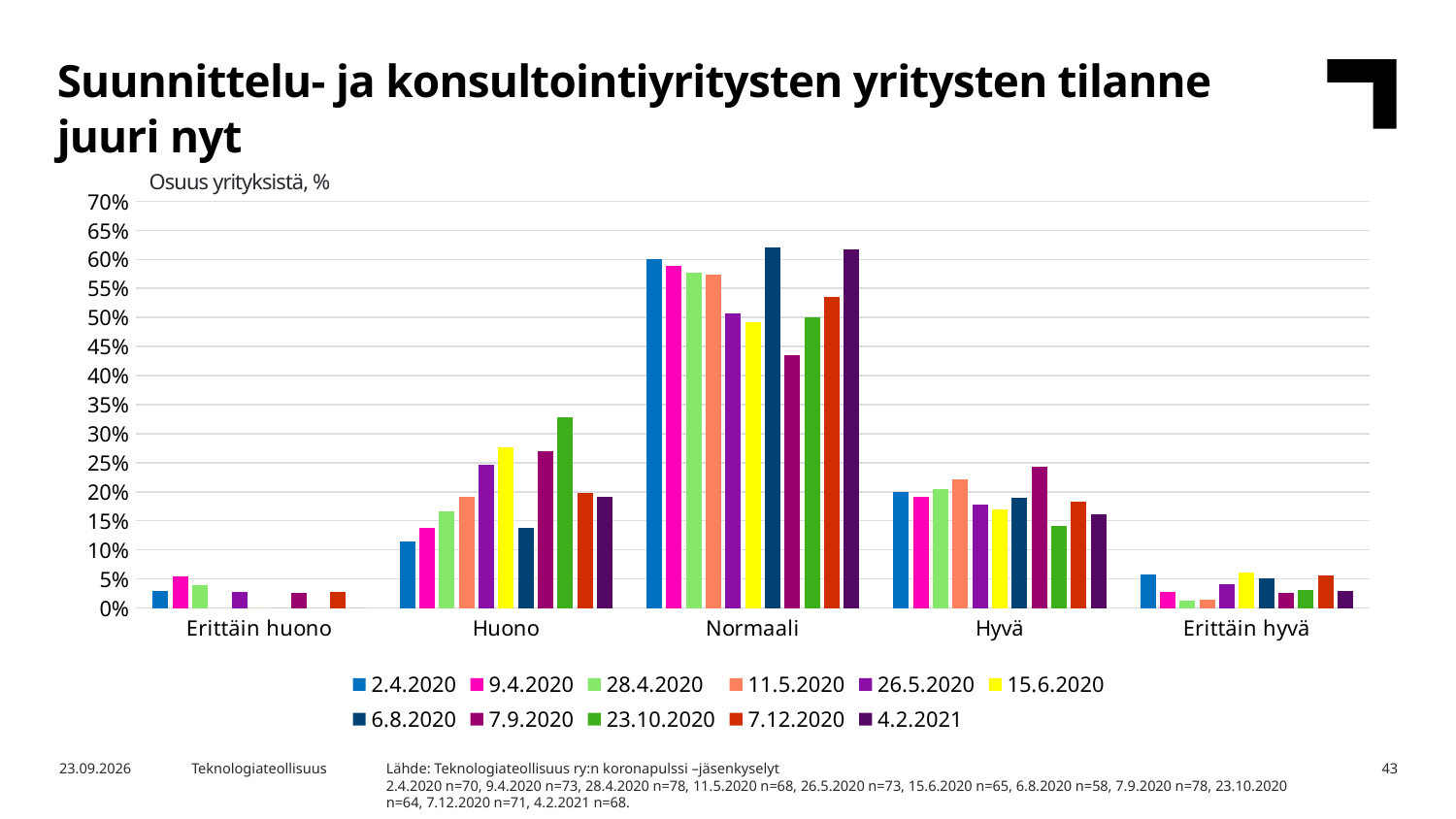
How many categories are shown on the x axis of the chart? 5 Is the value for Hyvä in the 7.9.2020 series greater or less than 20%? greater Which category has the highest value for the 2.4.2020 series? Normaali In the Normaali category, which is larger: the value for 26.5.2020 or the value for 6.8.2020? 6.8.2020 In the Huono category, which is larger: the value for 2.4.2020 or the value for 23.10.2020? 23.10.2020 What kind of chart is shown on the slide? bar chart Which series has the lowest value in the Normaali category? 7.9.2020 Is the value for Normaali in the 7.9.2020 series greater or less than 45%? less Which series has the highest value in the Huono category? 23.10.2020 How many series does the legend of the chart list? 11 Is the value for Huono in the 23.10.2020 series greater or less than 30%? greater What is the label shown above the y axis of the chart? Osuus yrityksistä, %